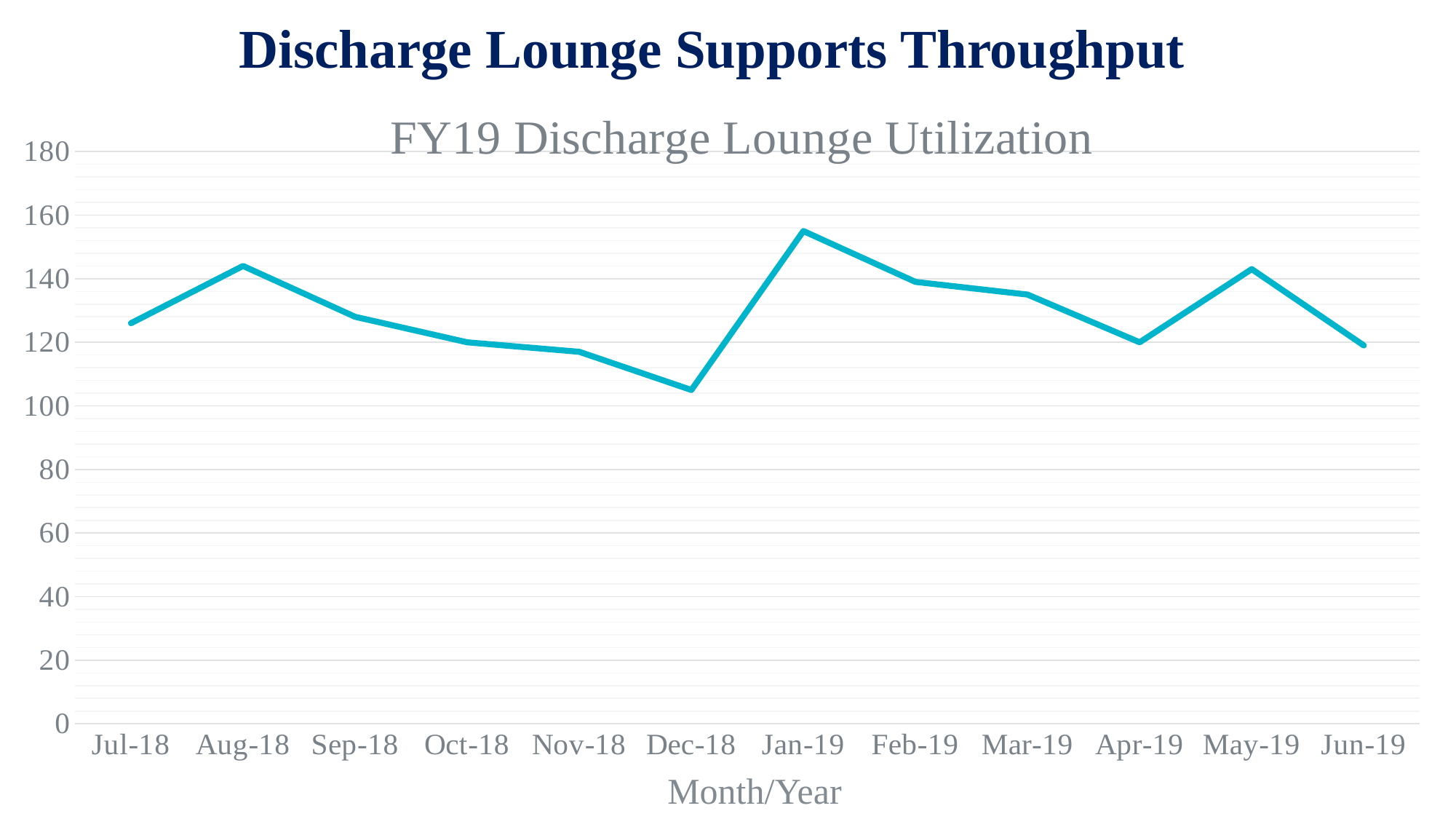
Which is larger, the value for Aug-18 or the value for Oct-18? Aug-18 Which month has the lowest discharge lounge utilization? Dec-18 What is the label of the x axis? Month/Year What is the title of the chart? FY19 Discharge Lounge Utilization How many months are plotted on the x axis? 12 Is the value for Jan-19 greater or less than 140? greater Which month has the highest discharge lounge utilization? Jan-19 Is the value for Dec-18 greater or less than 120? less Do the values rise or fall from Aug-18 to Dec-18? Fall Is the value for Apr-19 greater or less than 140? less Which is larger, the value for May-19 or the value for Jun-19? May-19 What kind of chart is shown on the slide? Line chart